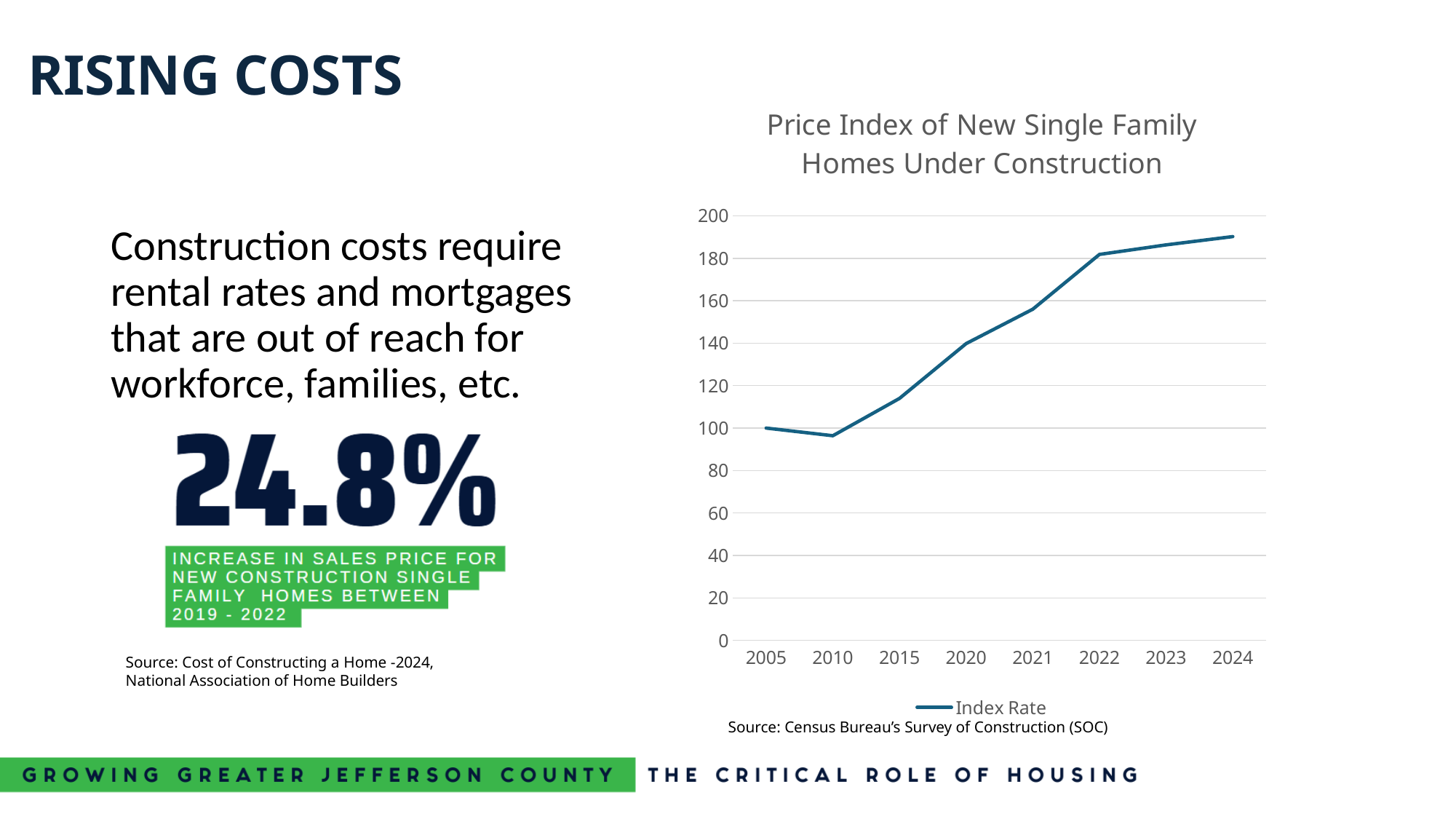
What kind of chart is shown on the slide? line chart Is the index rate for 2022 greater or less than 160? greater What is the name of the series shown in the chart legend? Index Rate What is the title of the chart? Price Index of New Single Family Homes Under Construction How many years are plotted on the x axis of the chart? 8 Does the index rate generally rise or fall from 2010 to 2024? rise Is the index rate for 2024 greater or less than 180? greater Which year has a higher index rate, 2020 or 2021? 2021 Which year has the highest index rate in the chart? 2024 How many series does the chart legend list? 1 Is the index rate for 2015 greater or less than 120? less Which year has the lowest index rate in the chart? 2010